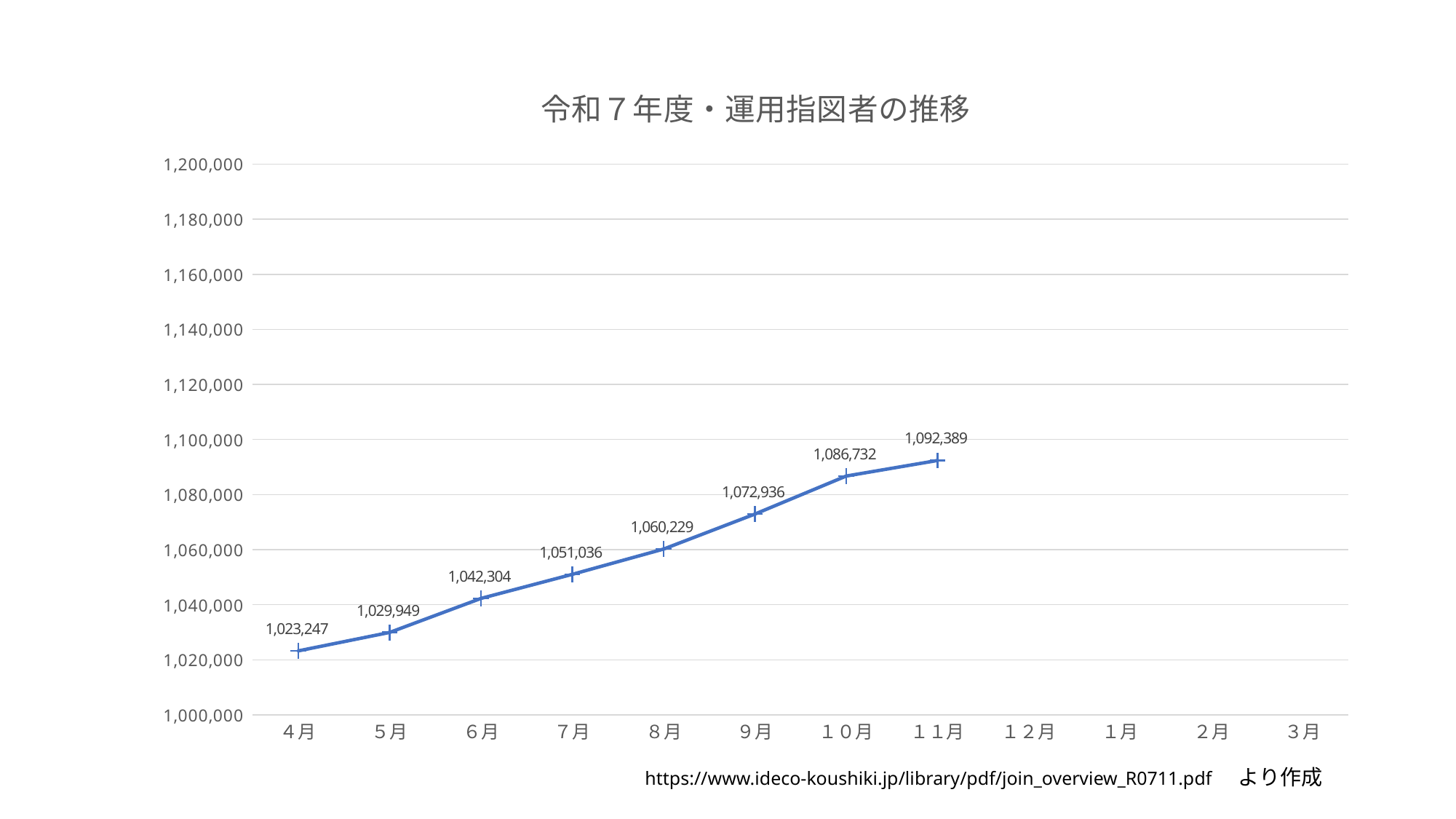
Is the value for 10月 greater or less than 1,080,000? greater How many data points are plotted on the line? 8 Do the values rise or fall from 4月 to 11月? Rise What is the value for 4月? 1,023,247 Which month has the highest plotted value? 11月 Which is larger, the value for 7月 or the value for 9月? 9月 What is the value for 8月? 1,060,229 What is the difference between the values for 10月 and 9月? 13,796 What is the value for 11月? 1,092,389 What kind of chart is shown? Line chart What is the difference between the values for 11月 and 4月? 69,142 Which month has the lowest plotted value? 4月